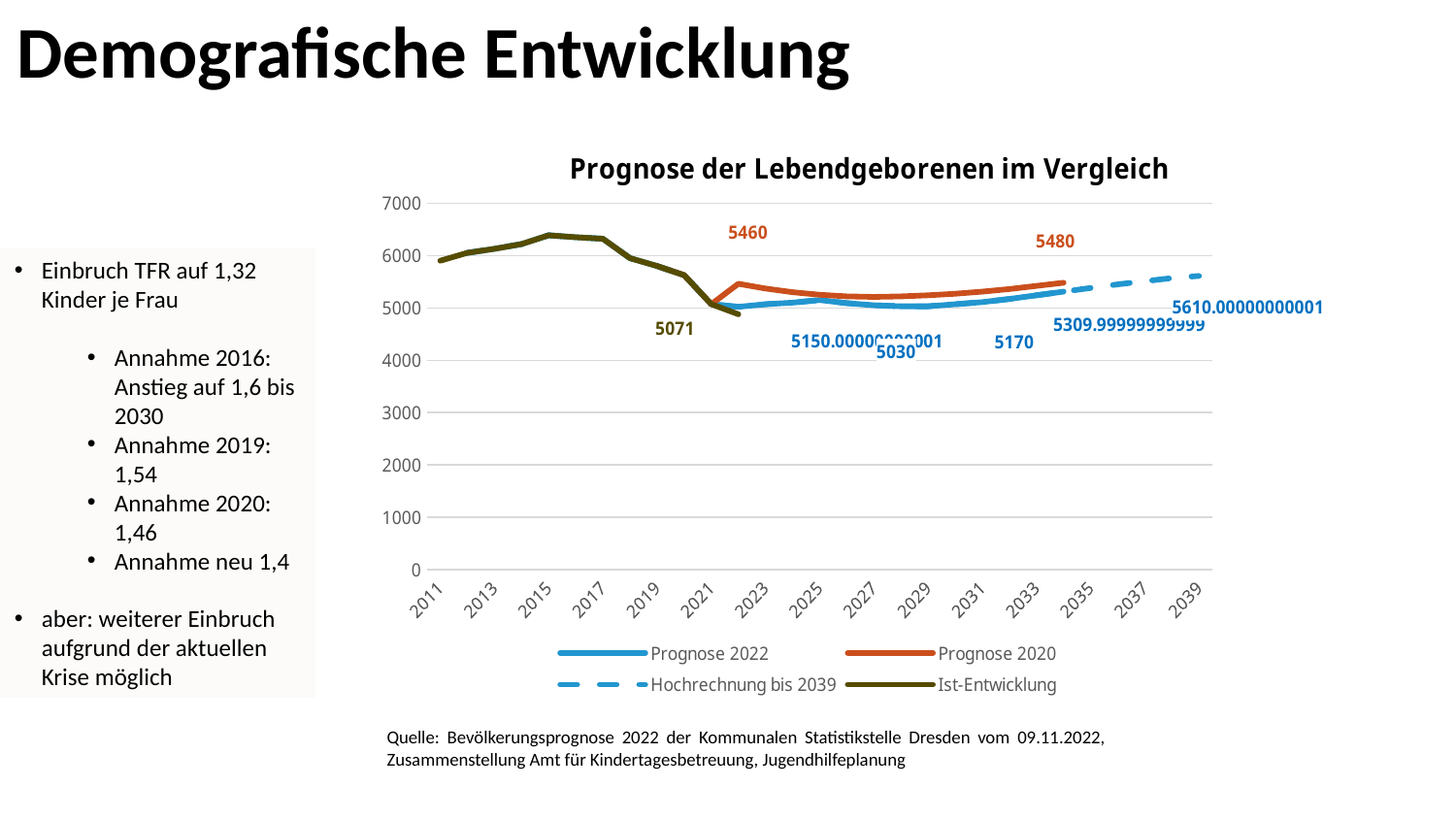
What kind of chart is shown on the slide? line chart What is the first labelled value of the Prognose 2020 series (around 2023)? 5460 What is the last labelled value of the Ist-Entwicklung series? 5071 What is the title of the chart? Prognose der Lebendgeborenen im Vergleich What is the labelled end value of the Hochrechnung bis 2039 series? 5610.00000000001 What is the lowest labelled value on the Prognose 2022 series? 5030 Around 2033, which series has the larger labelled value: Prognose 2020 or Prognose 2022? Prognose 2020 Is the value of the Ist-Entwicklung series in 2015 greater or less than 6000? greater How many series does the chart legend list? 4 Which series in the legend is drawn with a dashed line? Hochrechnung bis 2039 What is the difference between the two labelled values of the Prognose 2020 series, 5480 and 5460? 20 What is the labelled value of the Prognose 2020 series around 2033? 5480